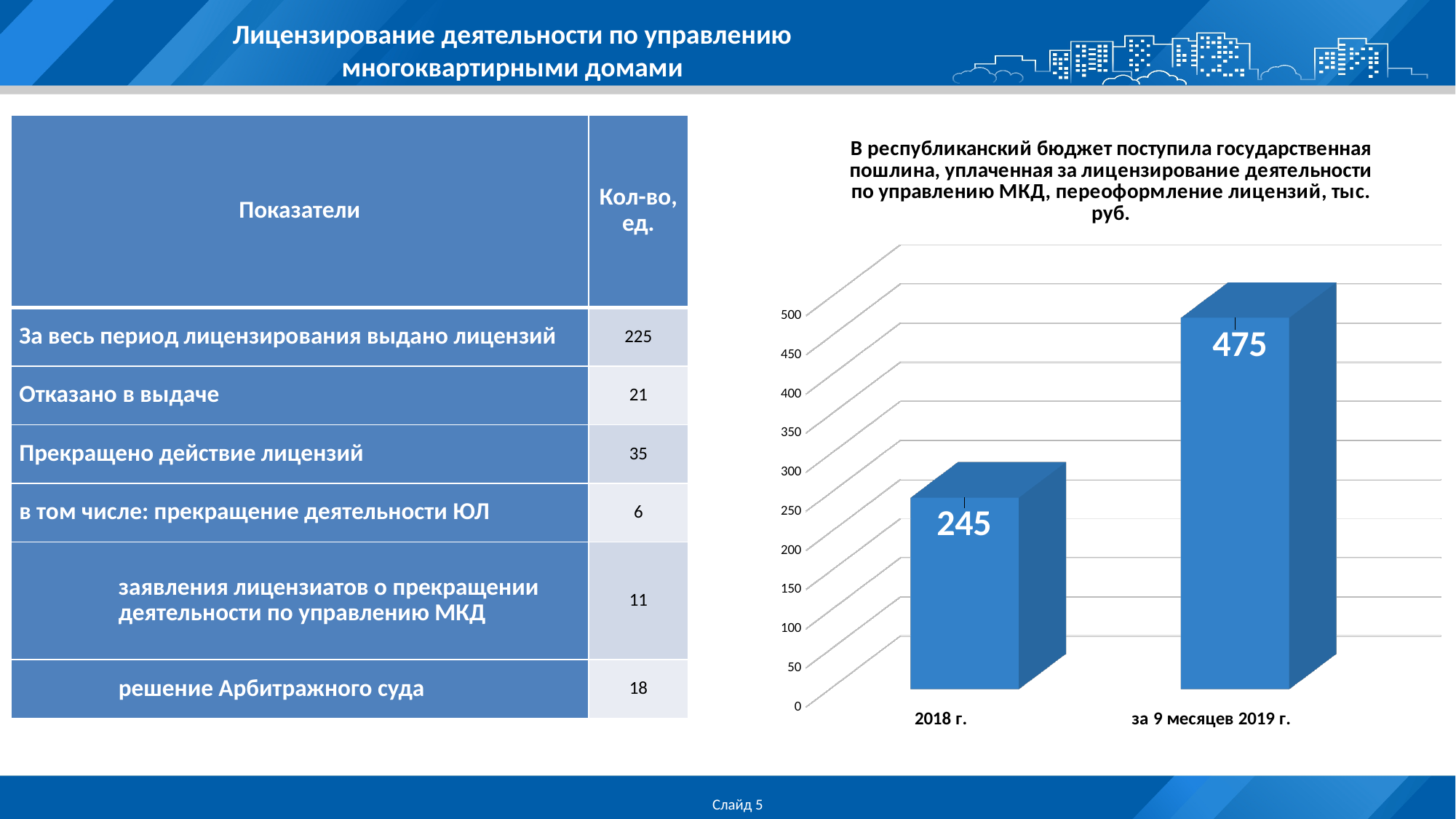
Which category has the highest value? за 9 месяцев 2019 г. What is the value for 2018 г.? 245 What is the highest tick value shown on the vertical axis of the chart? 500 Do the values rise or fall from 2018 г. to за 9 месяцев 2019 г.? rise How many categories are shown on the chart? 2 What is the difference between the values for за 9 месяцев 2019 г. and 2018 г.? 230 Which category has the lowest value? 2018 г. What is the value for за 9 месяцев 2019 г.? 475 Is the value for 2018 г. greater or less than 300? less Which is larger, the value for 2018 г. or the value for за 9 месяцев 2019 г.? за 9 месяцев 2019 г. What kind of chart is shown on the slide? bar chart Is the value for за 9 месяцев 2019 г. greater or less than 400? greater